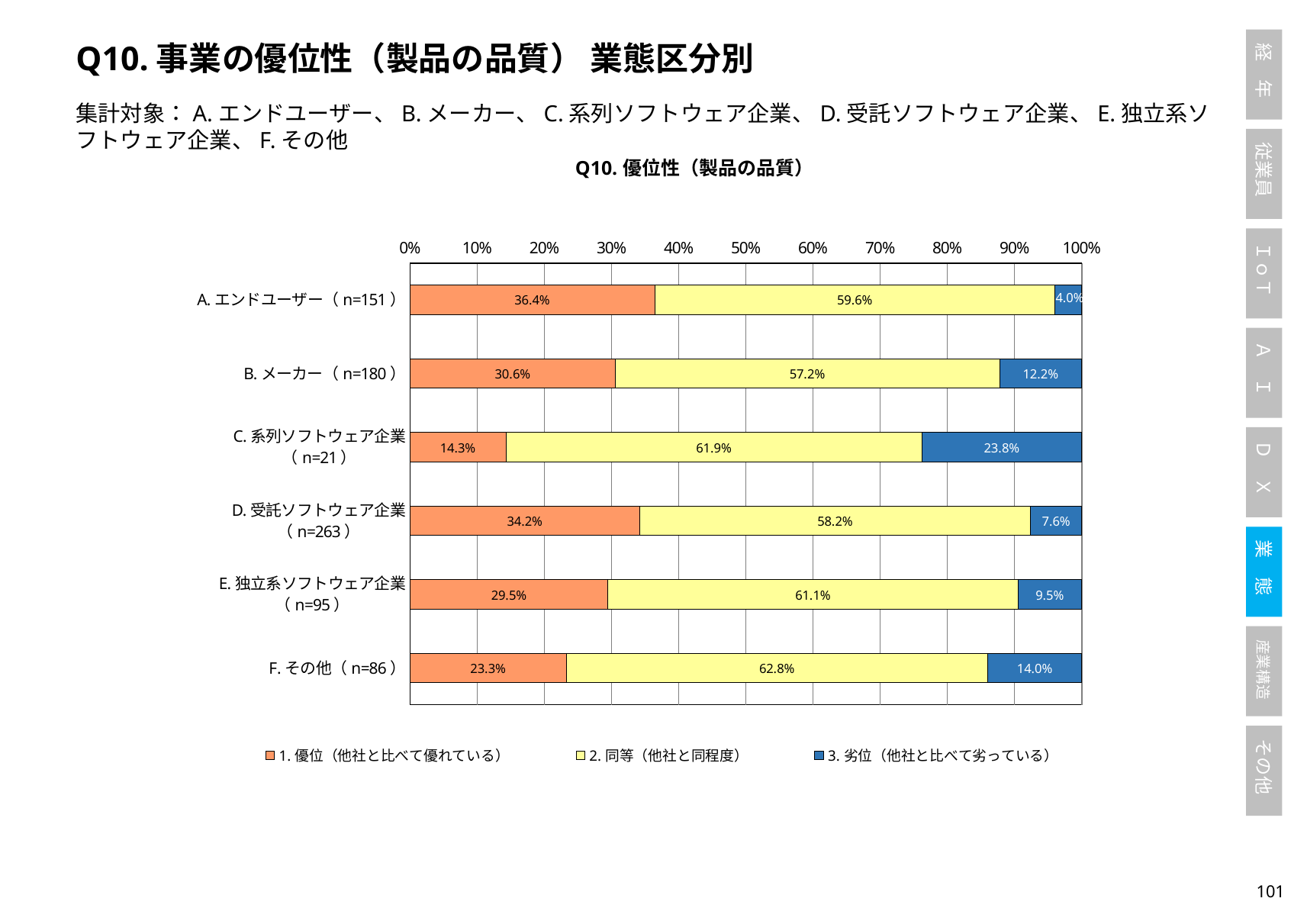
Which category has the lowest share for 3. 劣位（他社と比べて劣っている）? A. エンドユーザー (n=151) How many categories (業態区分) are shown on the chart? 6 What is the difference between the 3. 劣位 share of B. メーカー (n=180) and that of D. 受託ソフトウェア企業 (n=263)? 4.6% What percentage of A. エンドユーザー (n=151) answered 1. 優位（他社と比べて優れている）? 36.4% Which has a larger 2. 同等（他社と同程度） share: B. メーカー (n=180) or E. 独立系ソフトウェア企業 (n=95)? E. 独立系ソフトウェア企業 (n=95) Which category has the highest share for 1. 優位（他社と比べて優れている）? A. エンドユーザー (n=151) What percentage of F. その他 (n=86) answered 2. 同等（他社と同程度）? 62.8% Which category has the lowest share for 1. 優位（他社と比べて優れている）? C. 系列ソフトウェア企業 (n=21) What kind of chart is shown on the slide? Stacked bar chart What is the title of the chart? Q10. 優位性（製品の品質） What percentage of C. 系列ソフトウェア企業 (n=21) answered 3. 劣位（他社と比べて劣っている）? 23.8% How many series does the legend list? 3